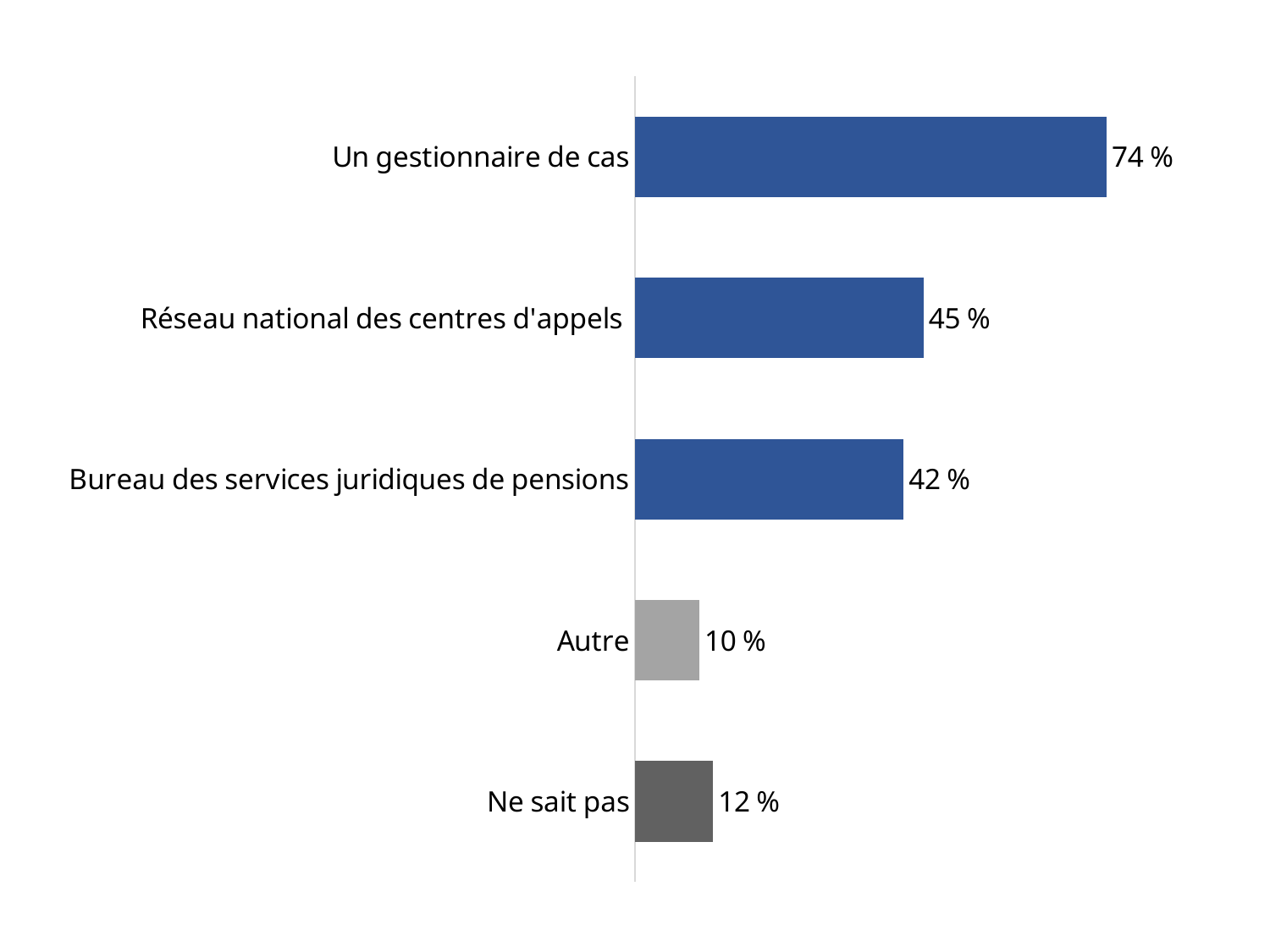
What is the difference between the values for "Un gestionnaire de cas" and "Réseau national des centres d'appels"? 29 % What is the value for "Autre"? 10 % Which is larger, the value for "Réseau national des centres d'appels" or for "Bureau des services juridiques de pensions"? Réseau national des centres d'appels What is the value for "Un gestionnaire de cas"? 74 % What is the value for "Ne sait pas"? 12 % What is the difference between the values for "Ne sait pas" and "Autre"? 2 % What kind of chart is shown on the slide? Bar chart What is the value for "Réseau national des centres d'appels"? 45 % Which category has the lowest value? Autre How many categories are shown in the chart? 5 What is the value for "Bureau des services juridiques de pensions"? 42 % Which category has the highest value? Un gestionnaire de cas